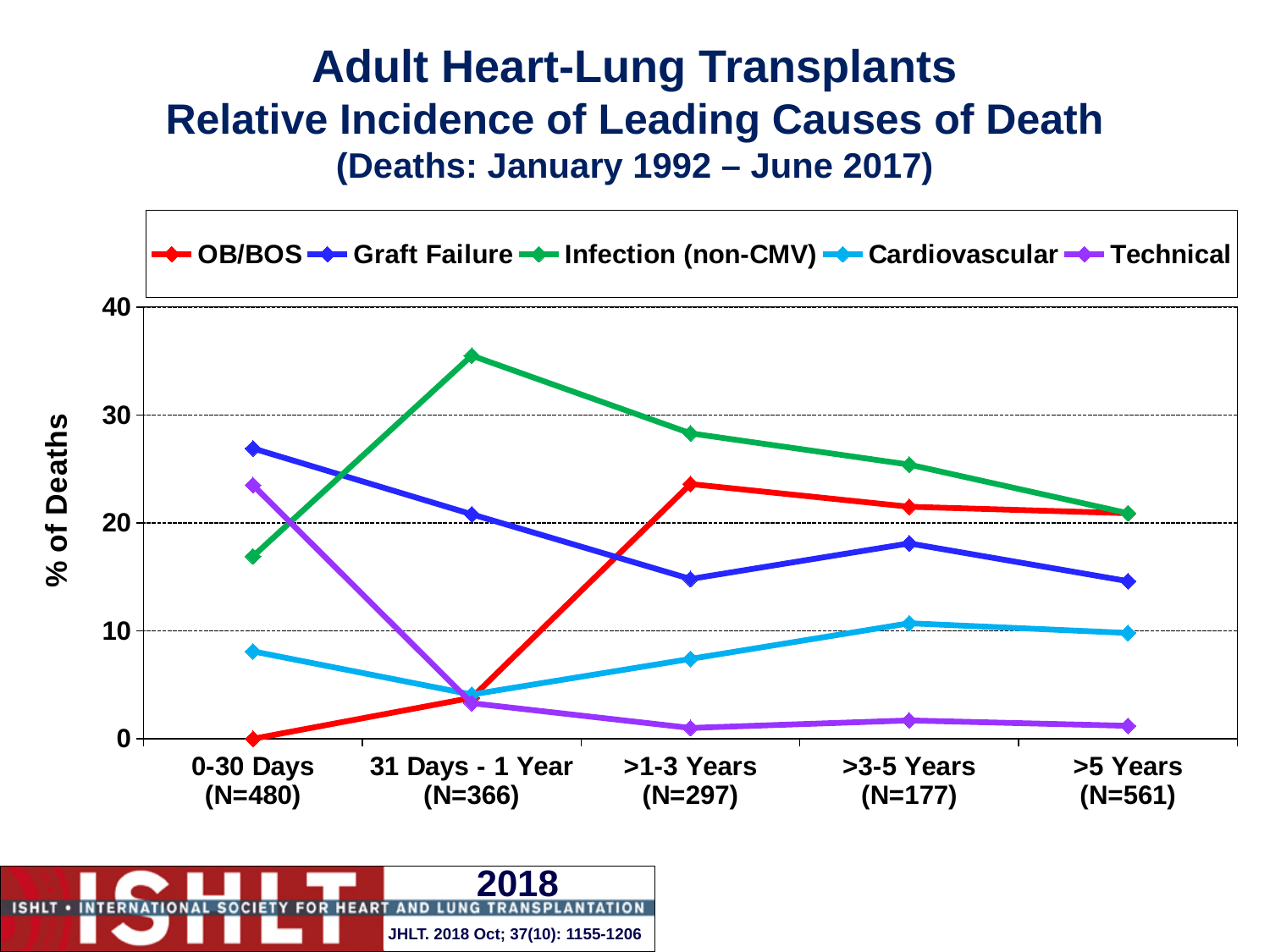
What is the N shown for the >5 Years category? 561 Which cause of death has the lowest % of deaths at >5 Years? Technical How many time-period categories are shown on the x axis? 5 What kind of chart is shown on the slide? line chart Is the value for Cardiovascular at 0-30 Days greater or less than 10? less Does the Technical line rise or fall from 0-30 Days to 31 Days - 1 Year? fall Which cause of death has the highest % of deaths at 31 Days - 1 Year? Infection (non-CMV) At 0-30 Days, which is larger: Graft Failure or Infection (non-CMV)? Graft Failure Is the value for Technical at >1-3 Years greater or less than 10? less How many series does the legend list? 5 Is the value for Infection (non-CMV) at 31 Days - 1 Year greater or less than 30? greater What is the label on the y axis? % of Deaths